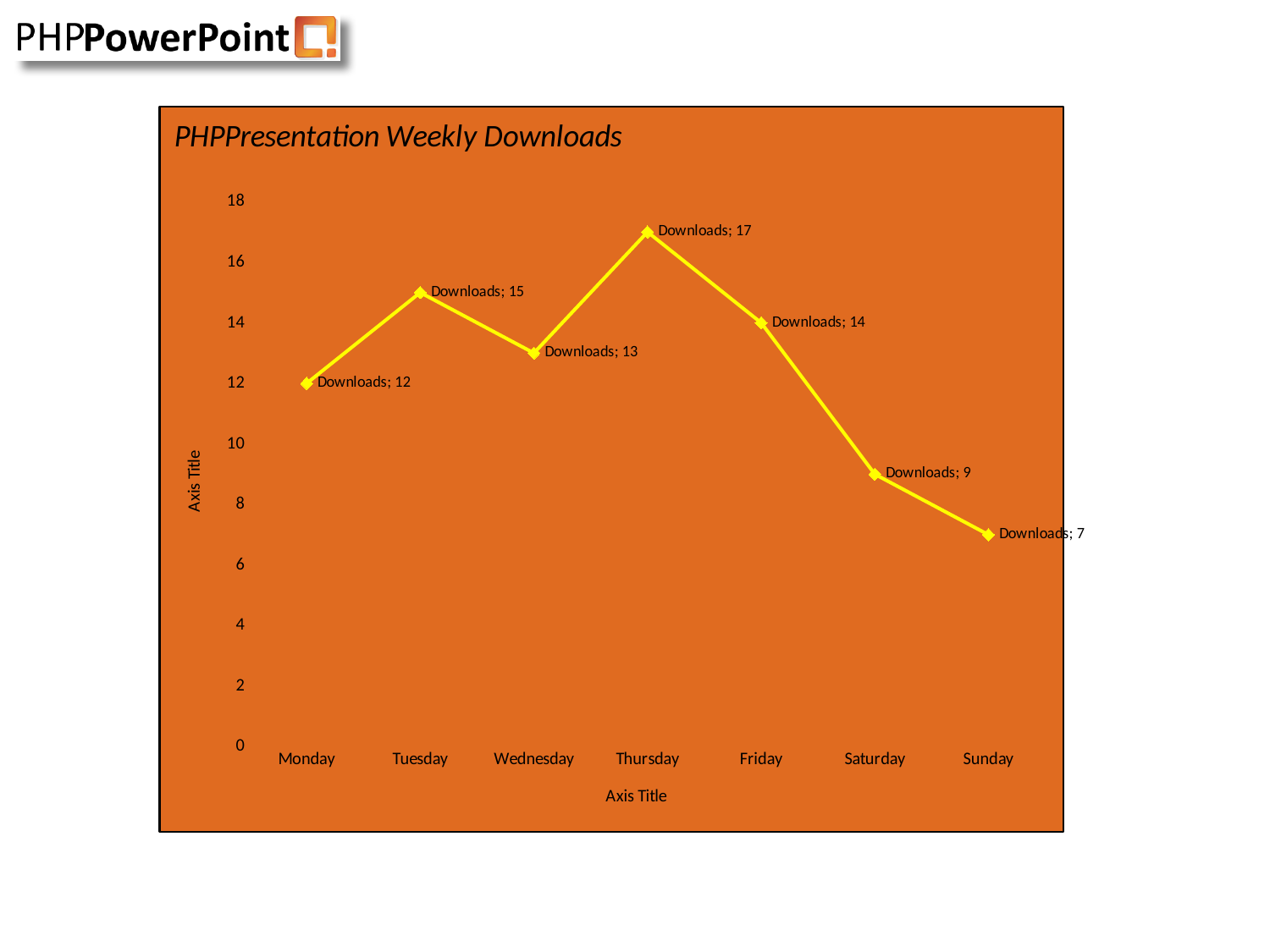
What is the title of the chart? PHPPresentation Weekly Downloads What is the value for Downloads on Thursday? 17 Which day has the lowest number of downloads? Sunday What is the difference between the downloads on Thursday and Sunday? 10 How many days are plotted on the x axis? 7 Do the downloads rise or fall from Thursday to Sunday? Fall What kind of chart is shown on the slide? Line chart What is the value for Downloads on Monday? 12 Which day has the highest number of downloads? Thursday What is the value for Downloads on Saturday? 9 What is the difference between the downloads on Tuesday and Wednesday? 2 Which day has more downloads, Friday or Saturday? Friday